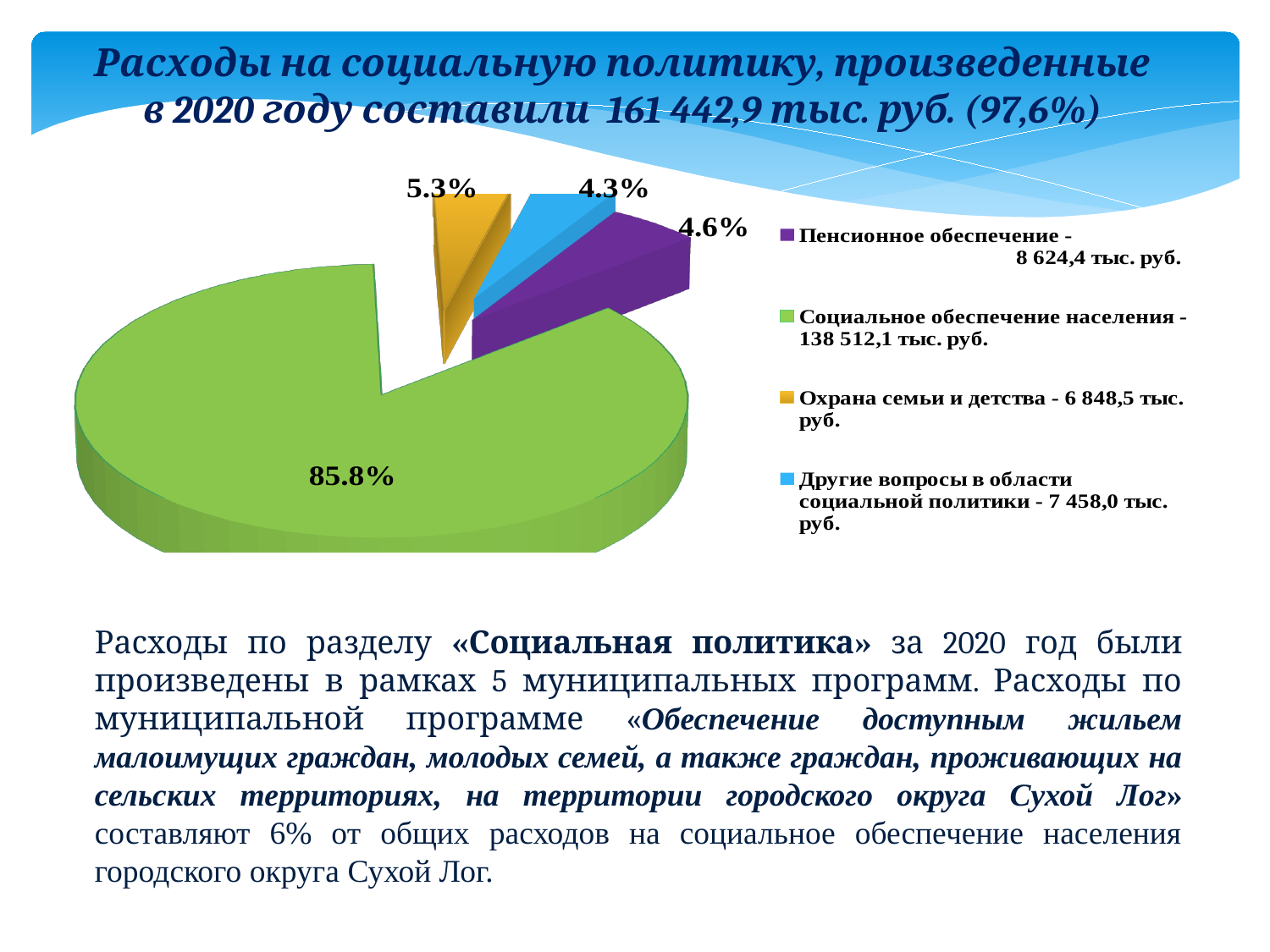
Which category has the largest expenditure? Социальное обеспечение населения According to the legend, what is the amount for Пенсионное обеспечение? 8 624,4 тыс. руб. How many slices does the pie chart have? 4 What is the difference between the amounts for Пенсионное обеспечение and Другие вопросы в области социальной политики? 1 166,4 тыс. руб. Which category has the smallest expenditure? Охрана семьи и детства According to the legend, what is the amount for Охрана семьи и детства? 6 848,5 тыс. руб. According to the legend, what is the amount for Социальное обеспечение населения? 138 512,1 тыс. руб. Which is larger: the amount for Пенсионное обеспечение or for Другие вопросы в области социальной политики? Пенсионное обеспечение What share of the pie does the largest slice (Социальное обеспечение населения) represent? 85.8% According to the legend, what is the amount for Другие вопросы в области социальной политики? 7 458,0 тыс. руб. What colour is the slice for Социальное обеспечение населения? green What kind of chart is shown on the slide? pie chart